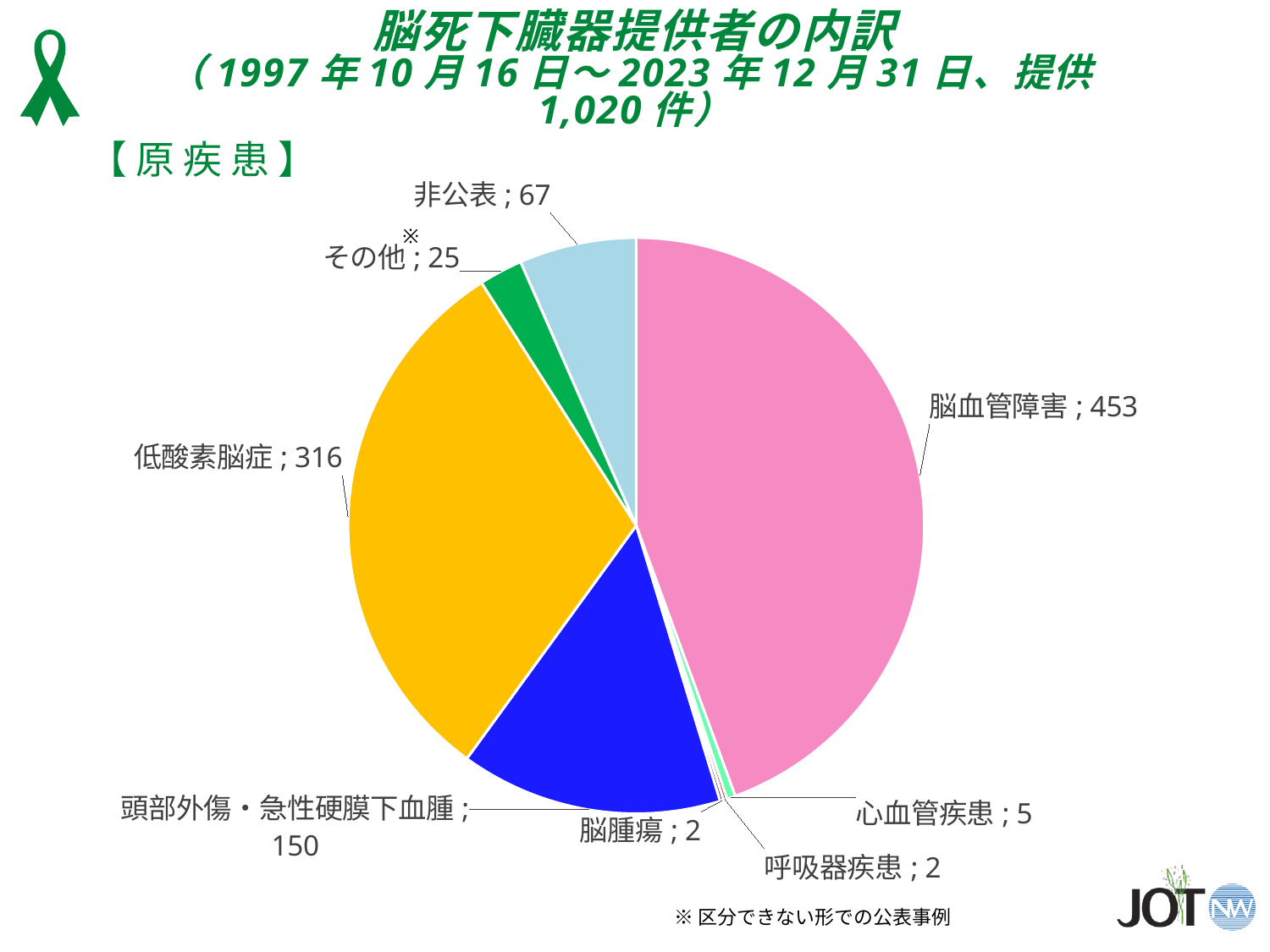
What is the value for 低酸素脳症? 316 What is the difference between the values for 脳血管障害 and 低酸素脳症? 137 What is the value for 脳血管障害? 453 What is the value for 心血管疾患? 5 What is the value for 非公表? 67 Which category has the largest slice of the pie? 脳血管障害 Which is larger, the value for 低酸素脳症 or the value for 頭部外傷・急性硬膜下血腫? 低酸素脳症 What is the value for 頭部外傷・急性硬膜下血腫? 150 What kind of chart is shown on the slide? pie chart What share of the total 1,020 cases does 脳血管障害 (453) represent, to one decimal place? 44.4% How many categories (slices) does the pie chart have? 8 What is the total number of cases stated in the chart title? 1,020 件